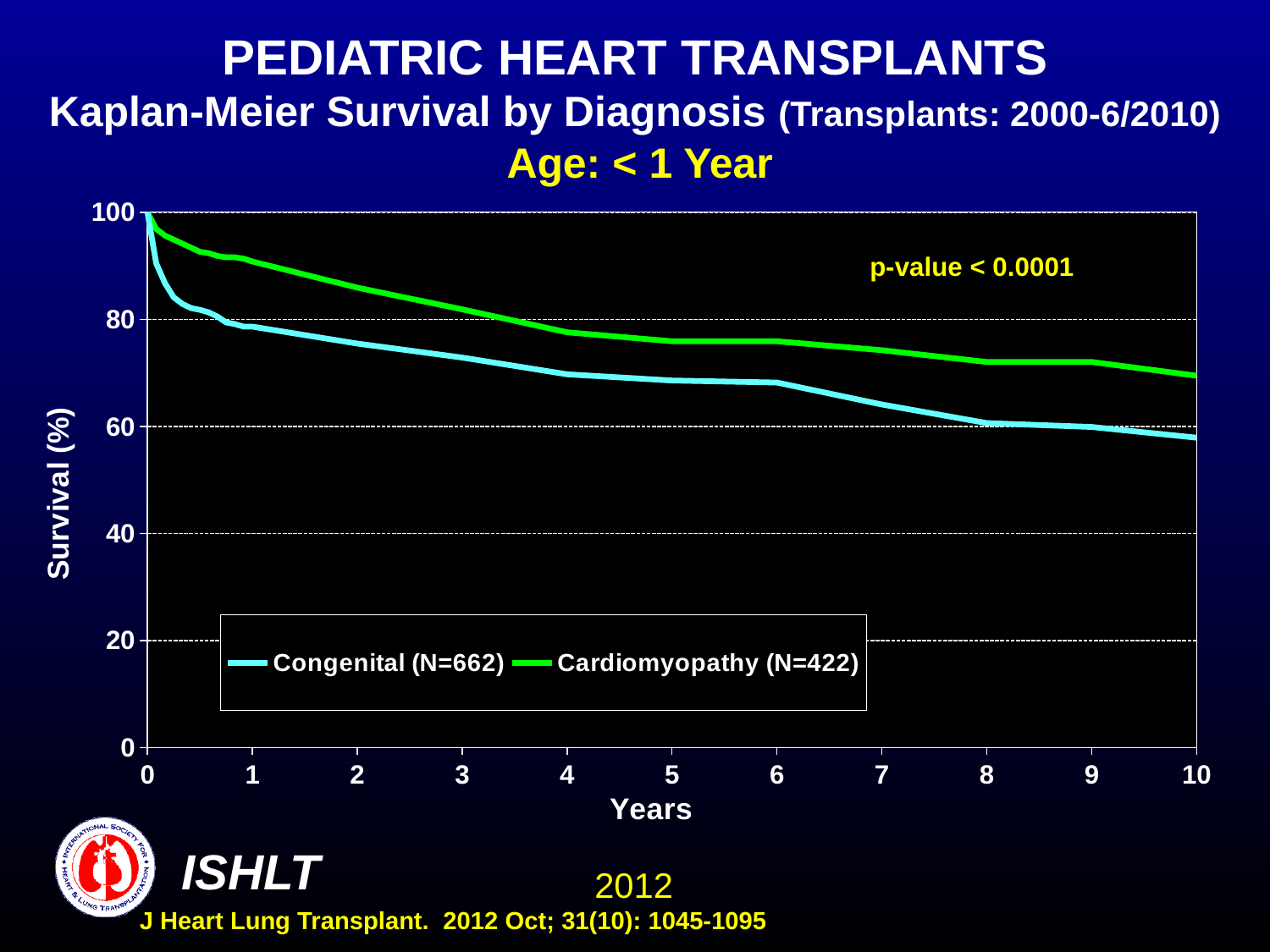
Is the survival value for Cardiomyopathy at year 8 greater or less than 80? less Which series has the higher survival at year 5, Congenital or Cardiomyopathy? Cardiomyopathy What p-value is shown on the chart? p-value < 0.0001 What kind of chart is shown on the slide? line chart Is the survival value for Congenital at year 10 greater or less than 60? less What is the N for the Congenital series in the legend? N=662 Do the survival values for Congenital rise or fall as years increase along the x axis? fall How many series does the legend list? 2 Is the survival value for Cardiomyopathy at year 10 greater or less than 60? greater Which series has the lower survival at year 2, Congenital or Cardiomyopathy? Congenital